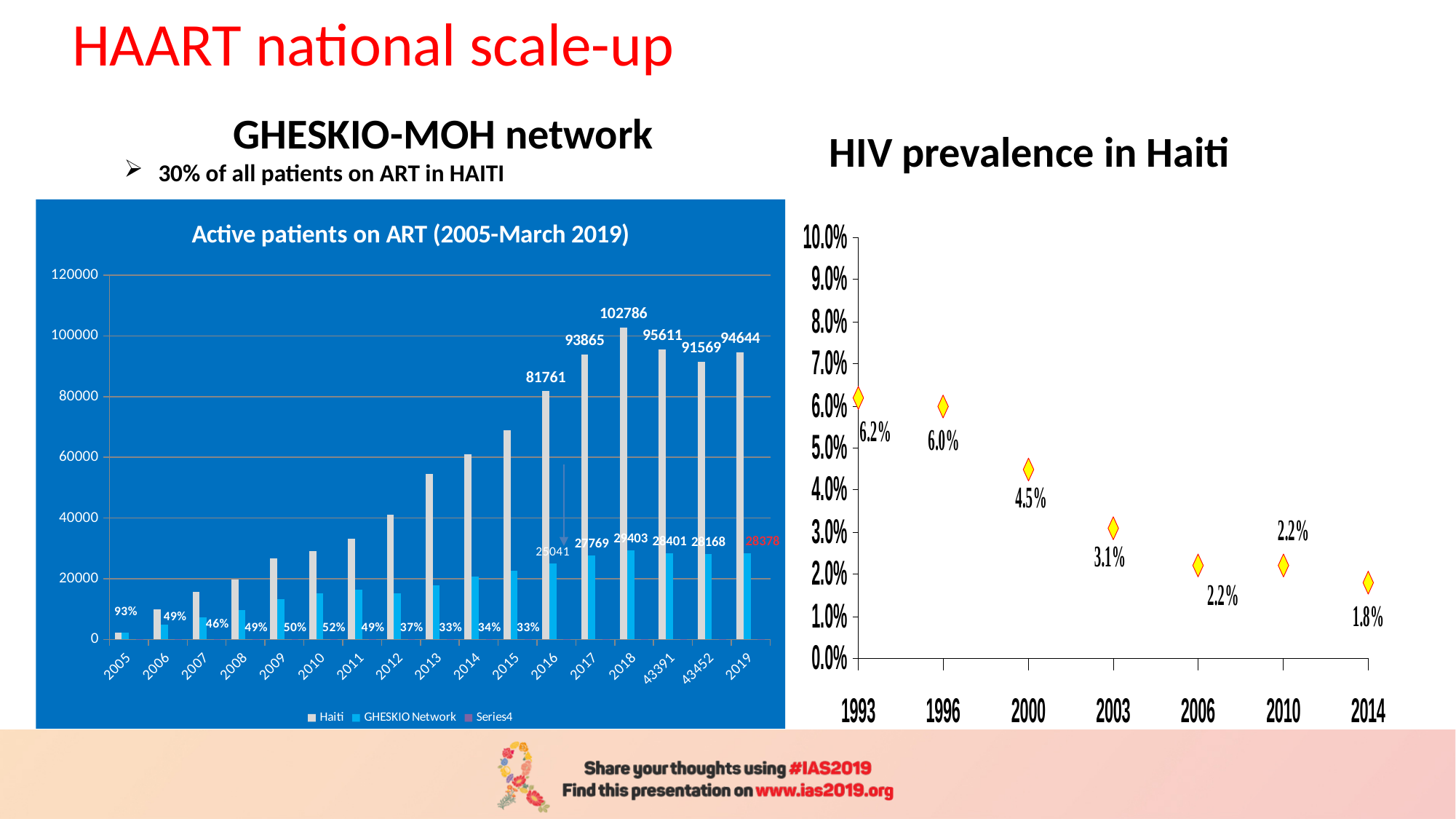
In the 'Active patients on ART (2005-March 2019)' chart, how many series does the legend list? 3 What kind of chart is 'Active patients on ART (2005-March 2019)'? Bar chart In the 'Active patients on ART (2005-March 2019)' chart, what is the difference between the Haiti values labelled for 2018 and 2017? 8921 In the 'HIV prevalence in Haiti' chart, which year has the lowest value? 2014 In the 'Active patients on ART (2005-March 2019)' chart, is the Haiti bar for 2015 greater or less than 60000? greater In the 'Active patients on ART (2005-March 2019)' chart, what is the GHESKIO Network value labelled for 2017? 27769 In the 'HIV prevalence in Haiti' chart, how many data points are plotted? 7 In the 'HIV prevalence in Haiti' chart, do the values rise or fall from 1993 to 2014? Fall In the 'Active patients on ART (2005-March 2019)' chart, which year has the highest labelled Haiti value? 2018 In the 'Active patients on ART (2005-March 2019)' chart, what is the Haiti value labelled for 2018? 102786 In the 'Active patients on ART (2005-March 2019)' chart, what percentage label is shown for 2005? 93% In the 'HIV prevalence in Haiti' chart, what is the value for 2000? 4.5%